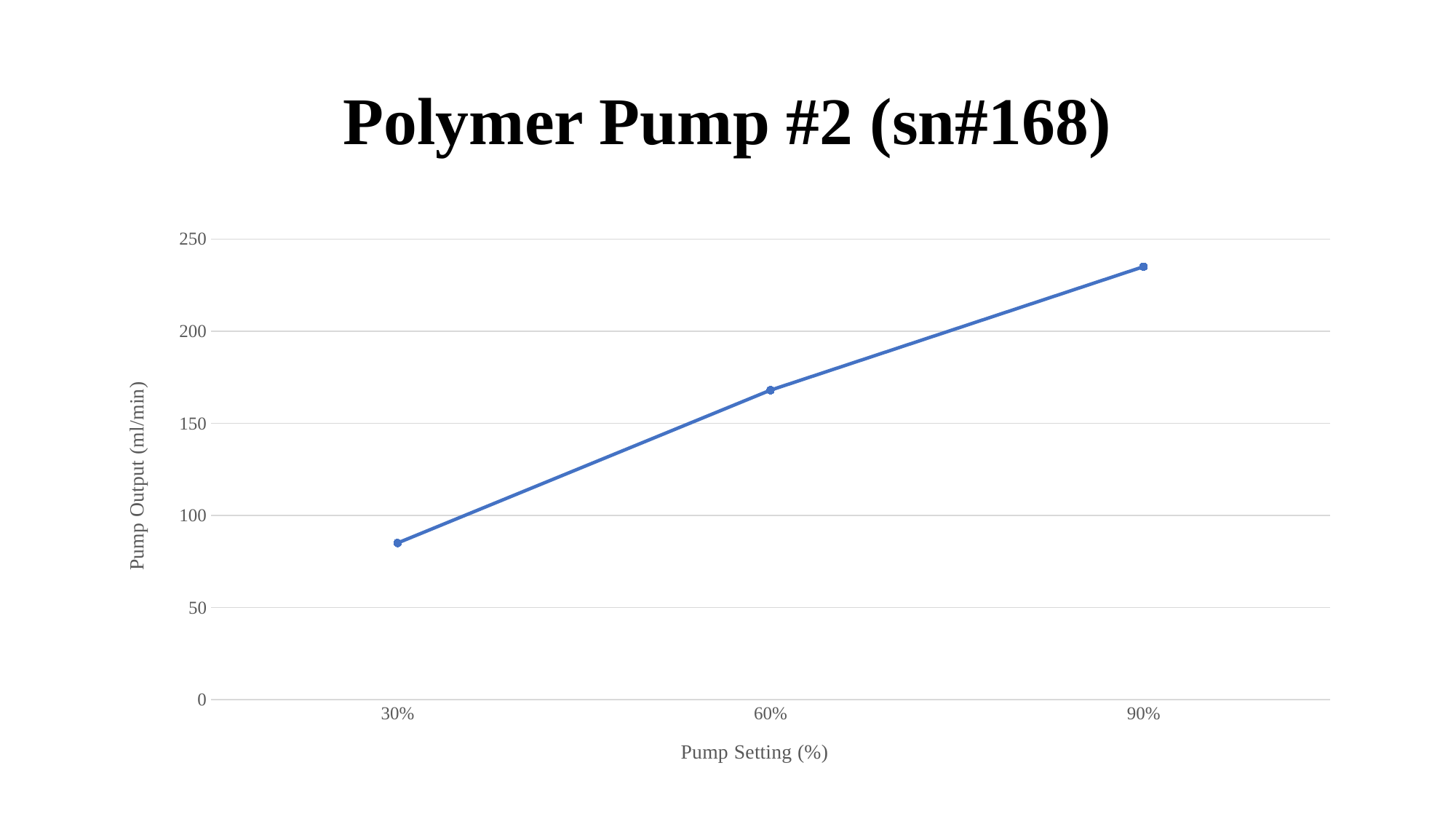
Does the pump output rise or fall as the pump setting increases from 30% to 90%? rise What kind of chart is shown on the slide? line chart What is the title of the chart? Polymer Pump #2 (sn#168) Which pump setting has the highest pump output? 90% Which pump setting has the lowest pump output? 30% What is the label of the vertical axis? Pump Output (ml/min) Is the pump output at the 90% setting greater or less than 200? greater Which has the larger pump output, the 30% setting or the 60% setting? 60% How many data points are plotted on the line? 3 Is the pump output at the 30% setting greater or less than 100? less Is the pump output at the 90% setting greater or less than 250? less